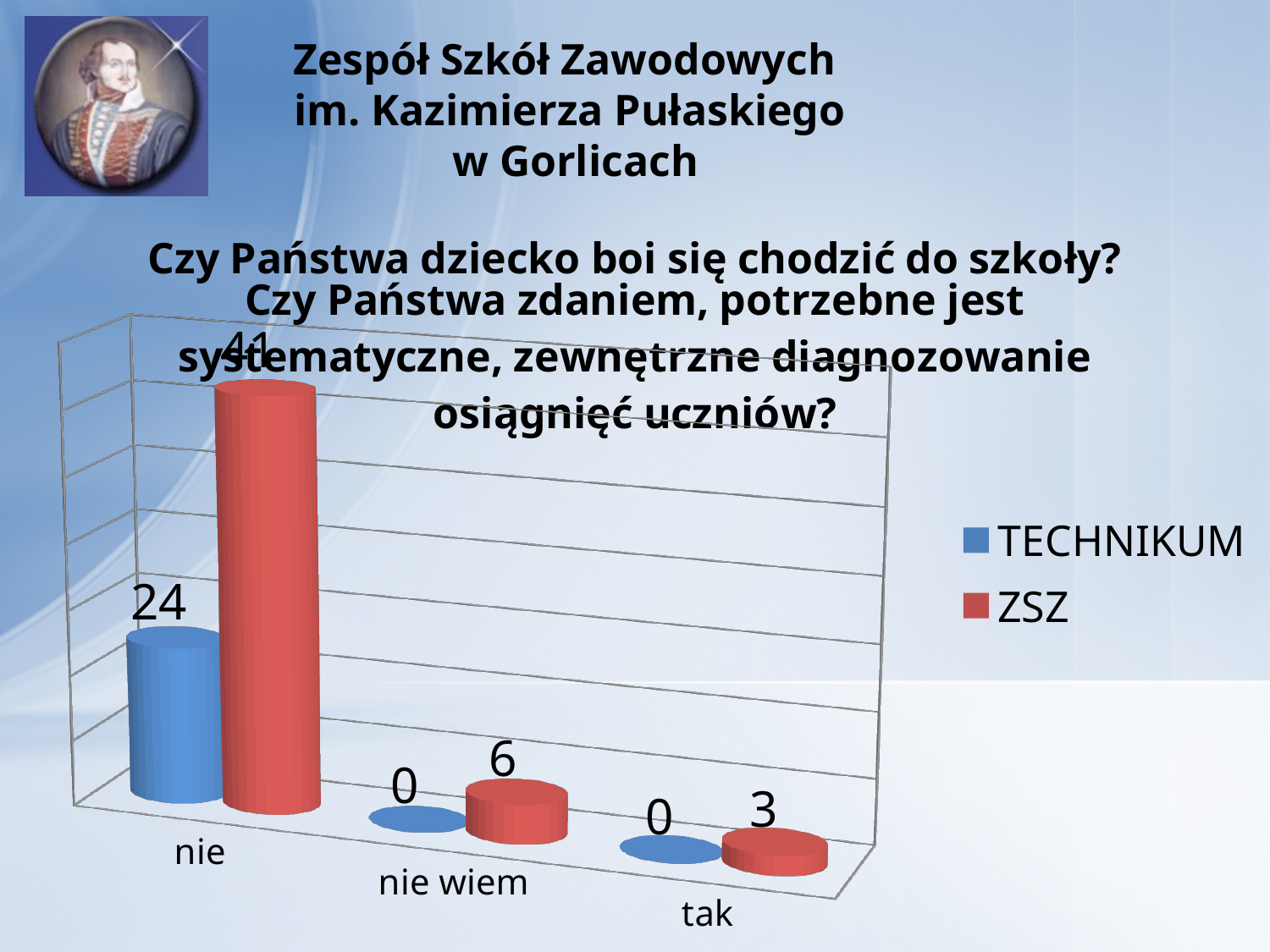
What is the value for TECHNIKUM in the "tak" category? 0 What is the value for ZSZ in the "tak" category? 3 How many categories are shown on the x axis? 3 What is the value for ZSZ in the "nie wiem" category? 6 What is the difference between the ZSZ and TECHNIKUM values in the "nie" category? 17 What is the value for ZSZ in the "nie" category? 41 What kind of chart is shown on the slide? bar chart In the "nie" category, which series has the larger value, TECHNIKUM or ZSZ? ZSZ Which category has the lowest value for ZSZ? tak What is the value for TECHNIKUM in the "nie" category? 24 Which category has the highest value for ZSZ? nie How many series does the legend list? 2